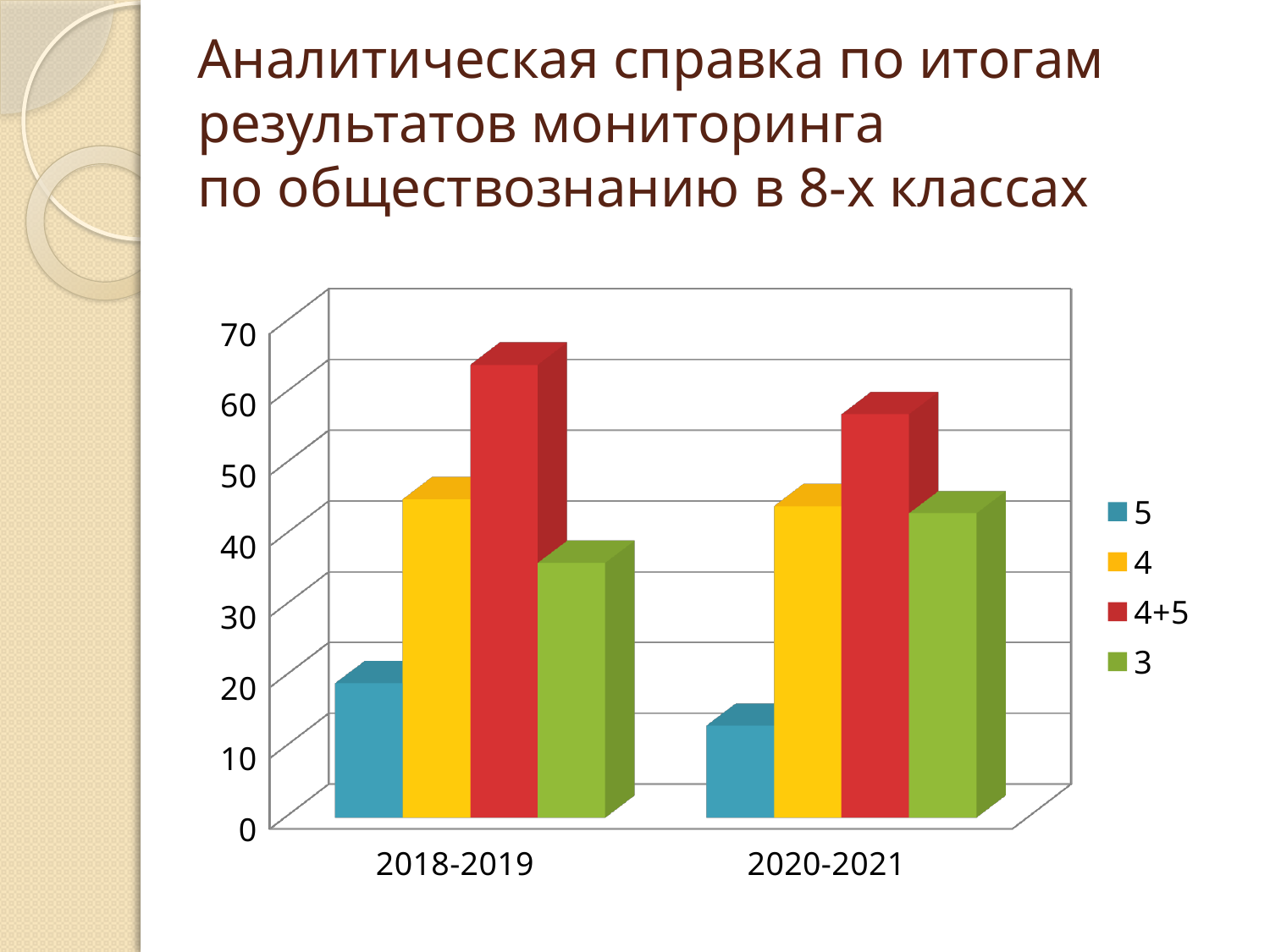
Does the value for series 5 rise or fall from 2018-2019 to 2020-2021? fall Which is larger: the value for series 3 in 2018-2019 or in 2020-2021? 2020-2021 How many categories are shown on the x axis? 2 How many series does the legend list? 4 Is the value for series 4+5 in 2018-2019 greater or less than 60? greater Is the value for series 4 in 2018-2019 greater or less than 40? greater What kind of chart is shown on the slide? bar chart Which is larger: the value for series 4+5 in 2018-2019 or in 2020-2021? 2018-2019 Which series has the lowest bar in the 2020-2021 group? 5 What are the entries listed in the legend? 5, 4, 4+5, 3 Which series has the highest bar in the 2018-2019 group? 4+5 Is the value for series 5 in 2020-2021 greater or less than 20? less